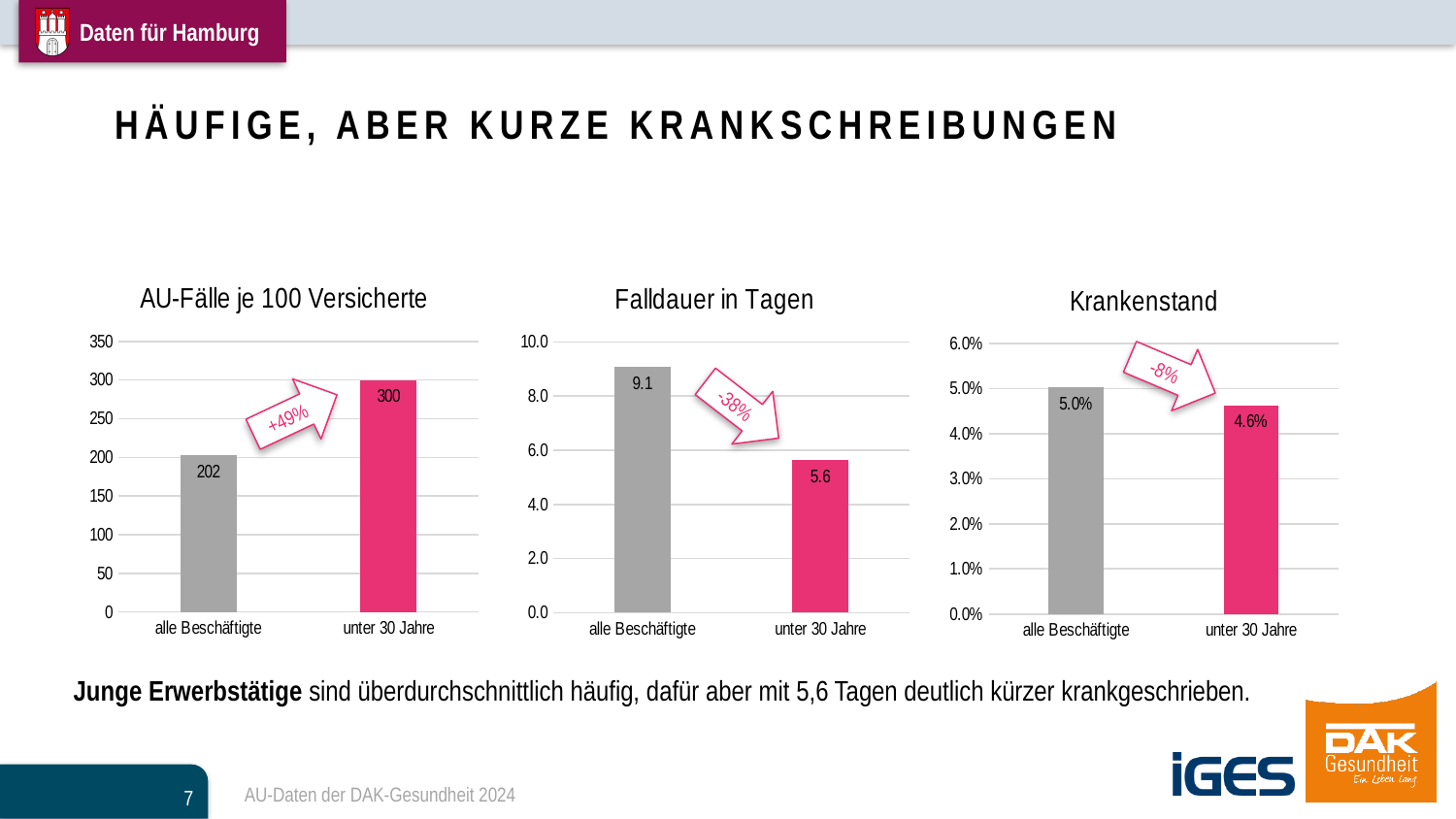
In the 'AU-Fälle je 100 Versicherte' chart, what is the value for 'alle Beschäftigte'? 202 In the 'AU-Fälle je 100 Versicherte' chart, which category has the lower value? alle Beschäftigte In the 'AU-Fälle je 100 Versicherte' chart, what is the value for 'unter 30 Jahre'? 300 In the 'Falldauer in Tagen' chart, is the value for 'alle Beschäftigte' greater or less than 8.0? greater How many categories does the 'Krankenstand' chart show? 2 In the 'Krankenstand' chart, what is the value for 'unter 30 Jahre'? 4.6% In the 'Falldauer in Tagen' chart, what is the value for 'unter 30 Jahre'? 5.6 What kind of chart is the 'Falldauer in Tagen' chart? bar chart In the 'AU-Fälle je 100 Versicherte' chart, what is the difference between 'unter 30 Jahre' and 'alle Beschäftigte'? 98 In the 'Falldauer in Tagen' chart, what is the difference between 'alle Beschäftigte' and 'unter 30 Jahre'? 3.5 In the 'Falldauer in Tagen' chart, what is the value for 'alle Beschäftigte'? 9.1 In the 'Krankenstand' chart, which category has the higher value? alle Beschäftigte